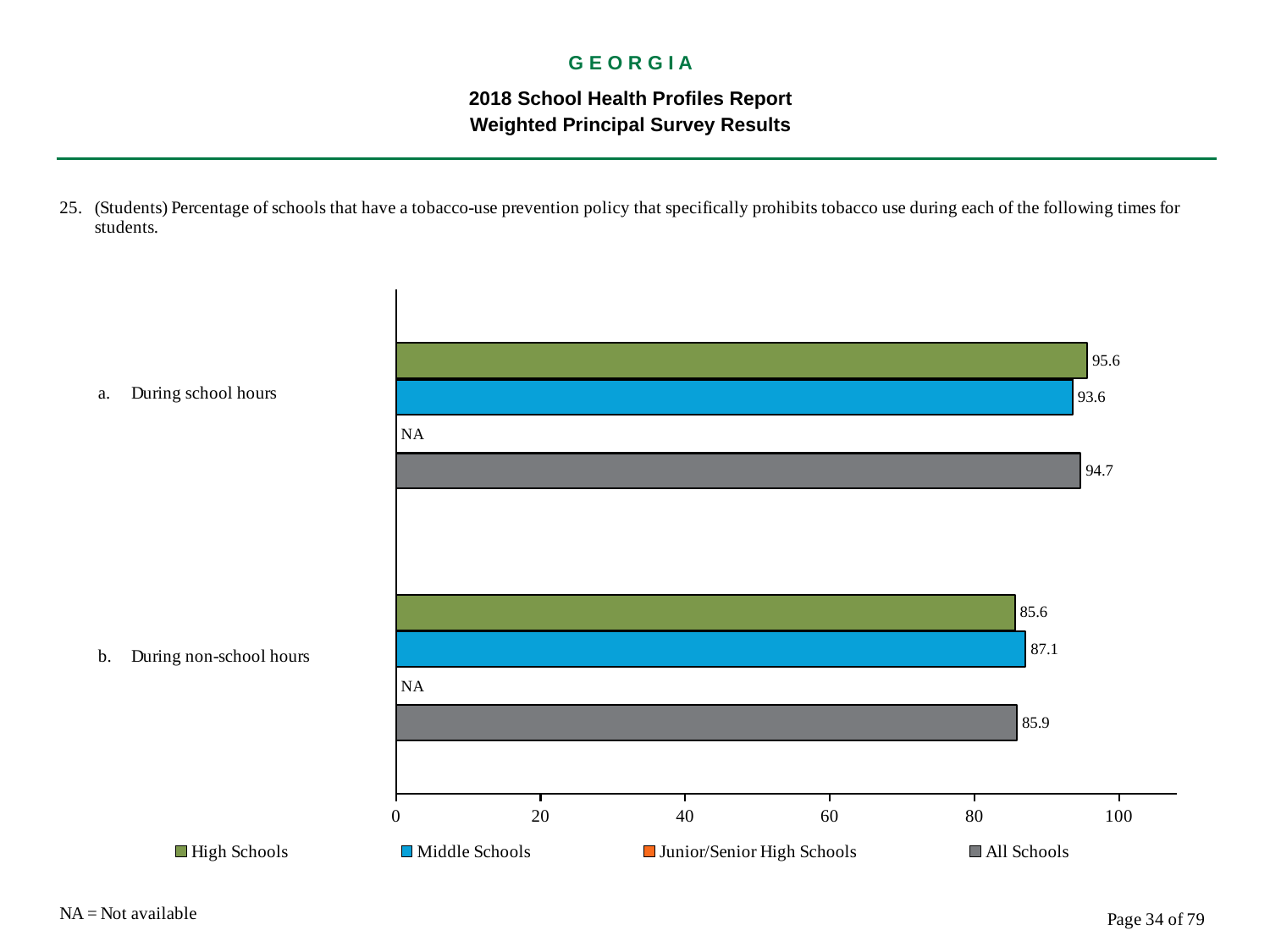
What is the value for Middle Schools during non-school hours? 87.1 What is the difference between the High Schools values for school hours and non-school hours? 10 What is shown for Junior/Senior High Schools during non-school hours? NA Which series has the lowest value during school hours (excluding NA)? Middle Schools Which is larger: the All Schools value during school hours or during non-school hours? During school hours How many series does the legend list? 4 What is the value for High Schools during school hours? 95.6 Is the value for Middle Schools during school hours greater or less than 80? greater Which series has the highest value during non-school hours? Middle Schools What kind of chart is shown on the slide? Bar chart What is the value for All Schools during school hours? 94.7 What colour represents All Schools in the legend? Gray